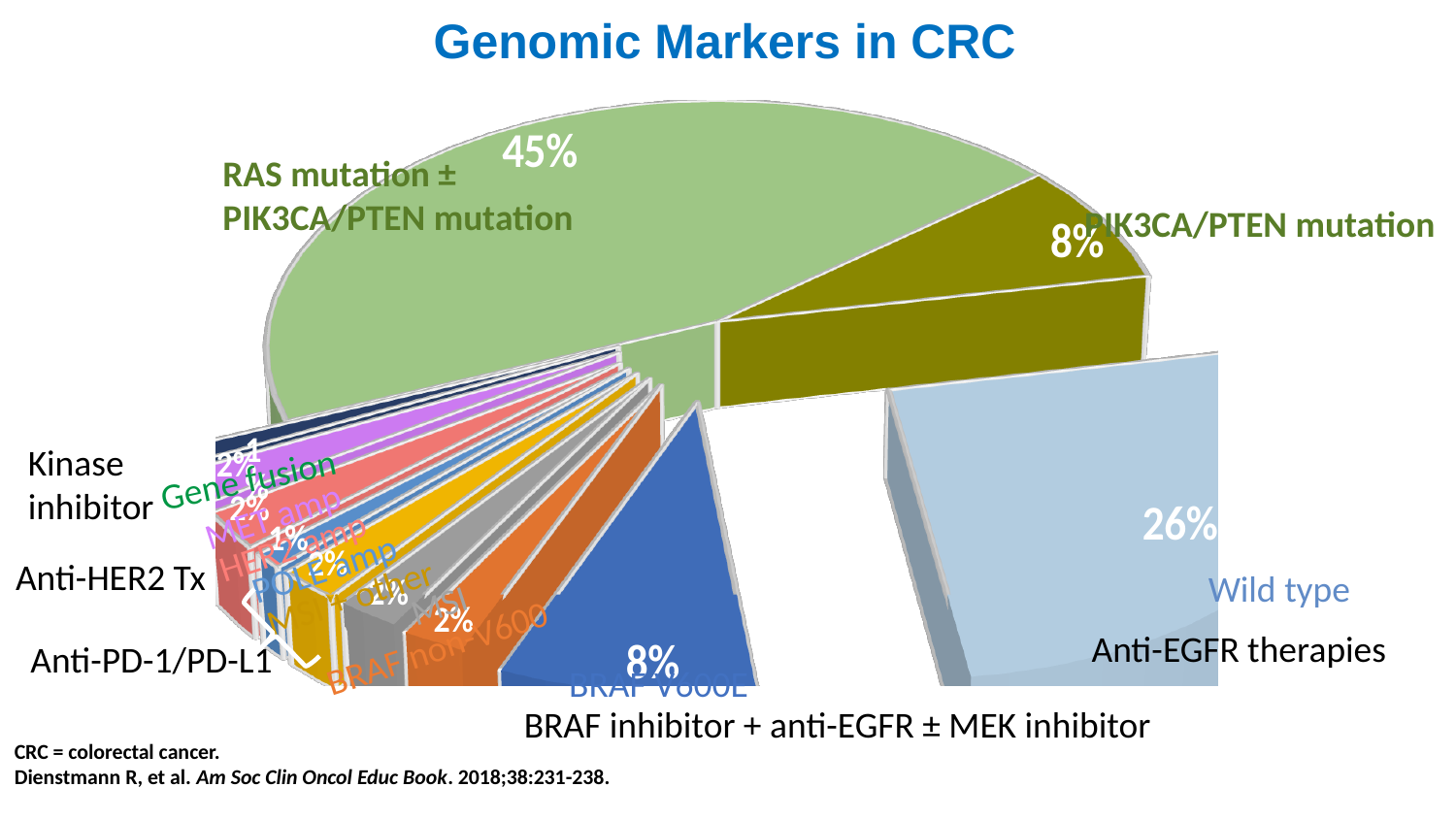
What is the difference in percentage points between the Wild type slice and the PIK3CA/PTEN mutation slice? 18% Which category has the largest slice of the pie? RAS mutation ± PIK3CA/PTEN mutation What percentage is shown for the BRAF V600E slice? 8% What percentage is shown for the RAS mutation ± PIK3CA/PTEN mutation slice? 45% What kind of chart is shown on the slide? Pie chart What is the difference in percentage points between the RAS mutation ± PIK3CA/PTEN mutation slice and the Wild type slice? 19% What percentage is shown for the PIK3CA/PTEN mutation slice? 8% Which is larger, the Wild type slice or the PIK3CA/PTEN mutation slice? Wild type Which therapy is annotated next to the Wild type slice? Anti-EGFR therapies What is the title of the chart? Genomic Markers in CRC What percentage is shown for the Wild type slice? 26% Which is larger, the RAS mutation ± PIK3CA/PTEN mutation slice or the BRAF V600E slice? RAS mutation ± PIK3CA/PTEN mutation